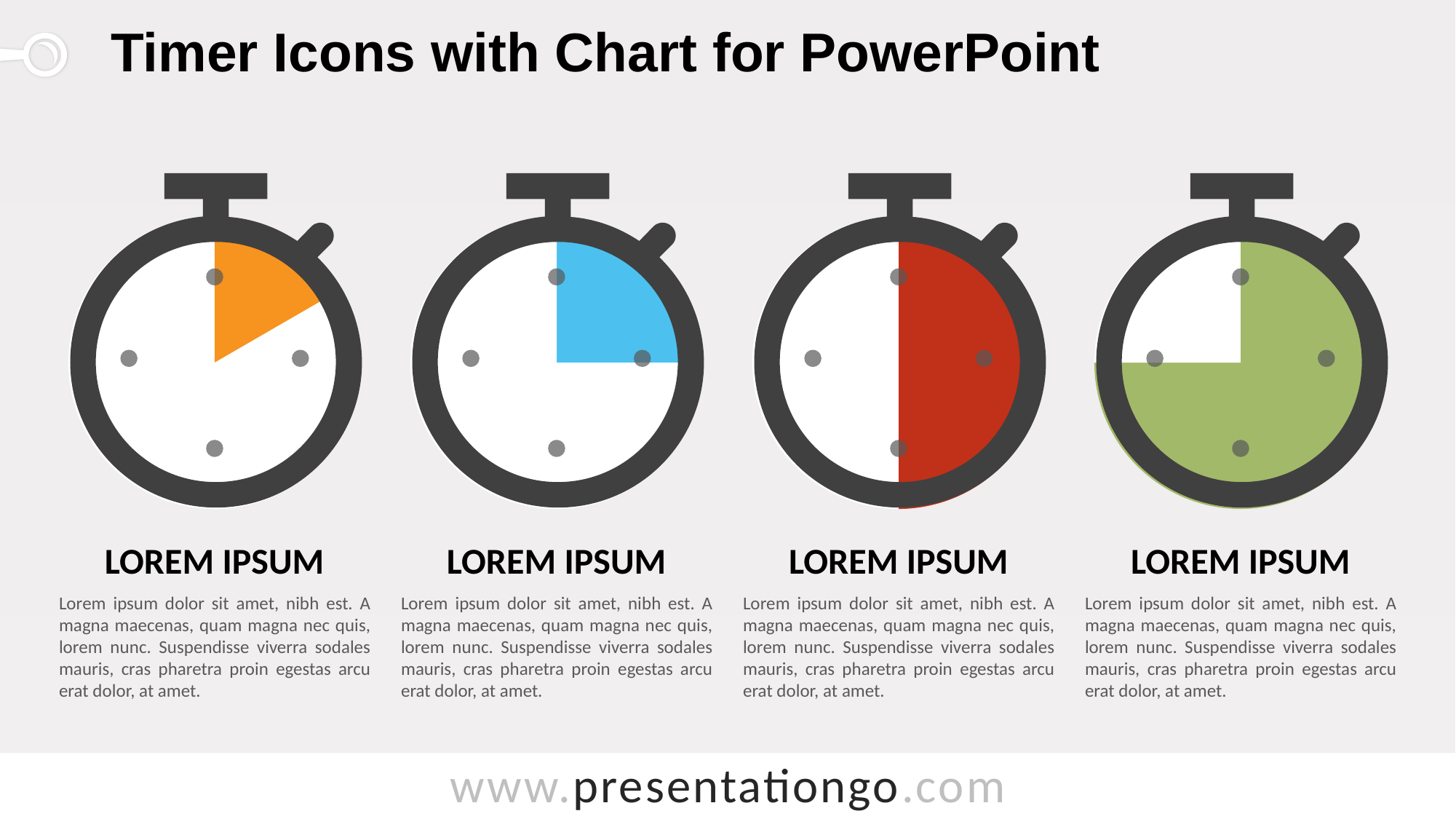
Which timer icon has the smallest filled portion? The first (orange) timer What is the title of the slide? Timer Icons with Chart for PowerPoint Is the filled portion of the third (red) timer larger or smaller than that of the second (blue) timer? Larger Is the filled portion of the first (orange) timer larger or smaller than that of the fourth (green) timer? Smaller What colour is the filled portion of the second timer icon? Blue Which timer icon has the largest filled portion? The fourth (green) timer Do the filled portions of the timers increase or decrease from left to right across the slide? Increase What kind of chart is used inside each timer icon? Pie chart How many timer icons with charts are shown on the slide? 4